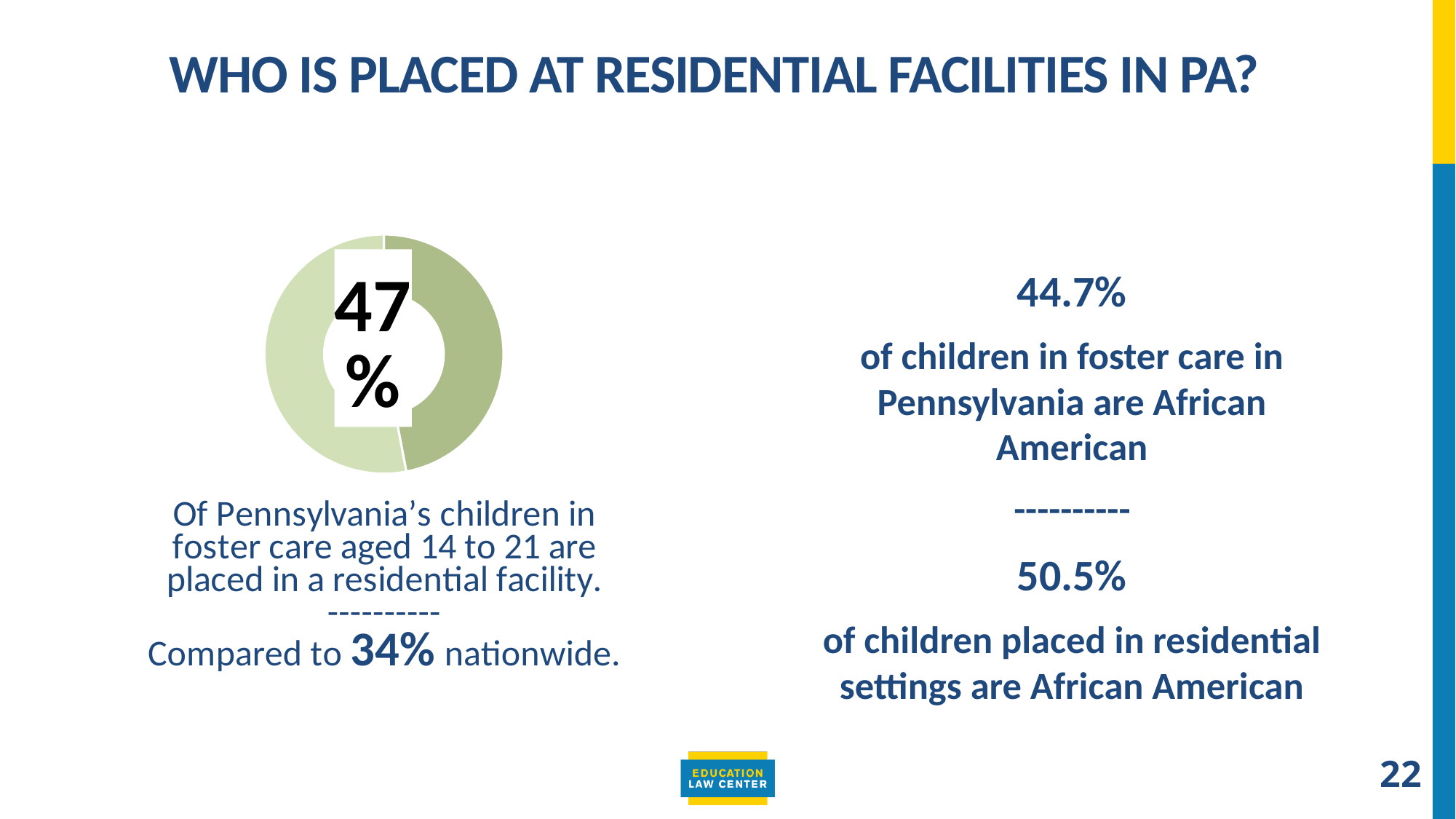
What percentage is printed in the centre of the donut chart? 47% According to the text below the donut chart, what share of Pennsylvania's children in foster care aged 14 to 21 are placed in a residential facility? 47% How many slices does the donut chart have? 2 Is the value shown on the donut chart greater or less than 50%? less What kind of chart is shown on the slide? Donut chart What nationwide percentage is the donut chart's 47% compared to in the text below it? 34% Does the donut chart have a legend? No